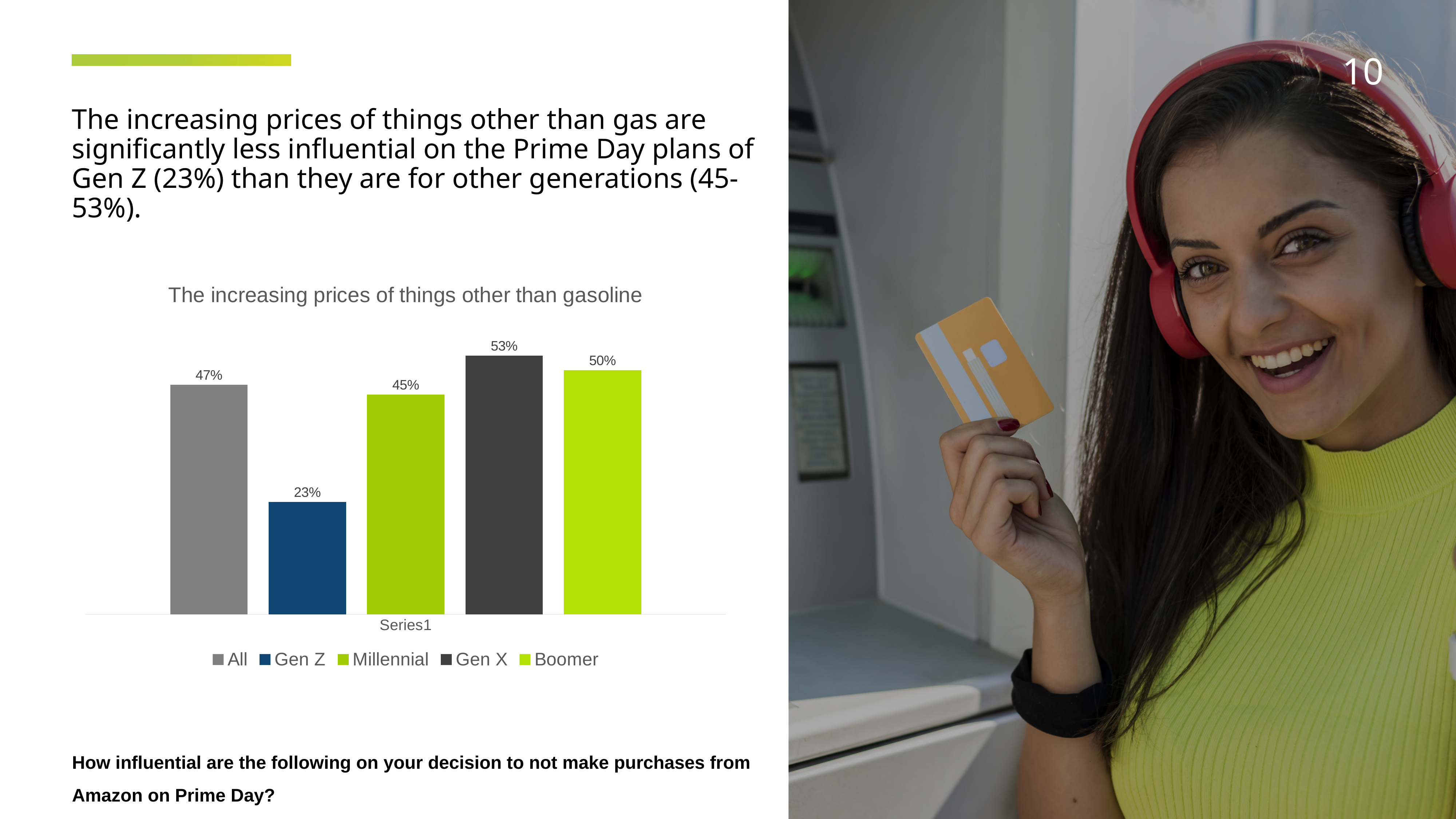
What is the difference between the Boomer and Millennial values? 5% What is the difference between the Gen X and Gen Z values? 30% How many series does the legend list? 5 What is the value for Boomer? 50% Which group has the highest value? Gen X Which group has the lowest value? Gen Z What kind of chart is shown? Bar chart What is the value for Gen X? 53% Which is larger, the value for Millennial or the value for Gen Z? Millennial What is the value for All? 47% What is the value for Gen Z? 23% What is the title of the chart? The increasing prices of things other than gasoline